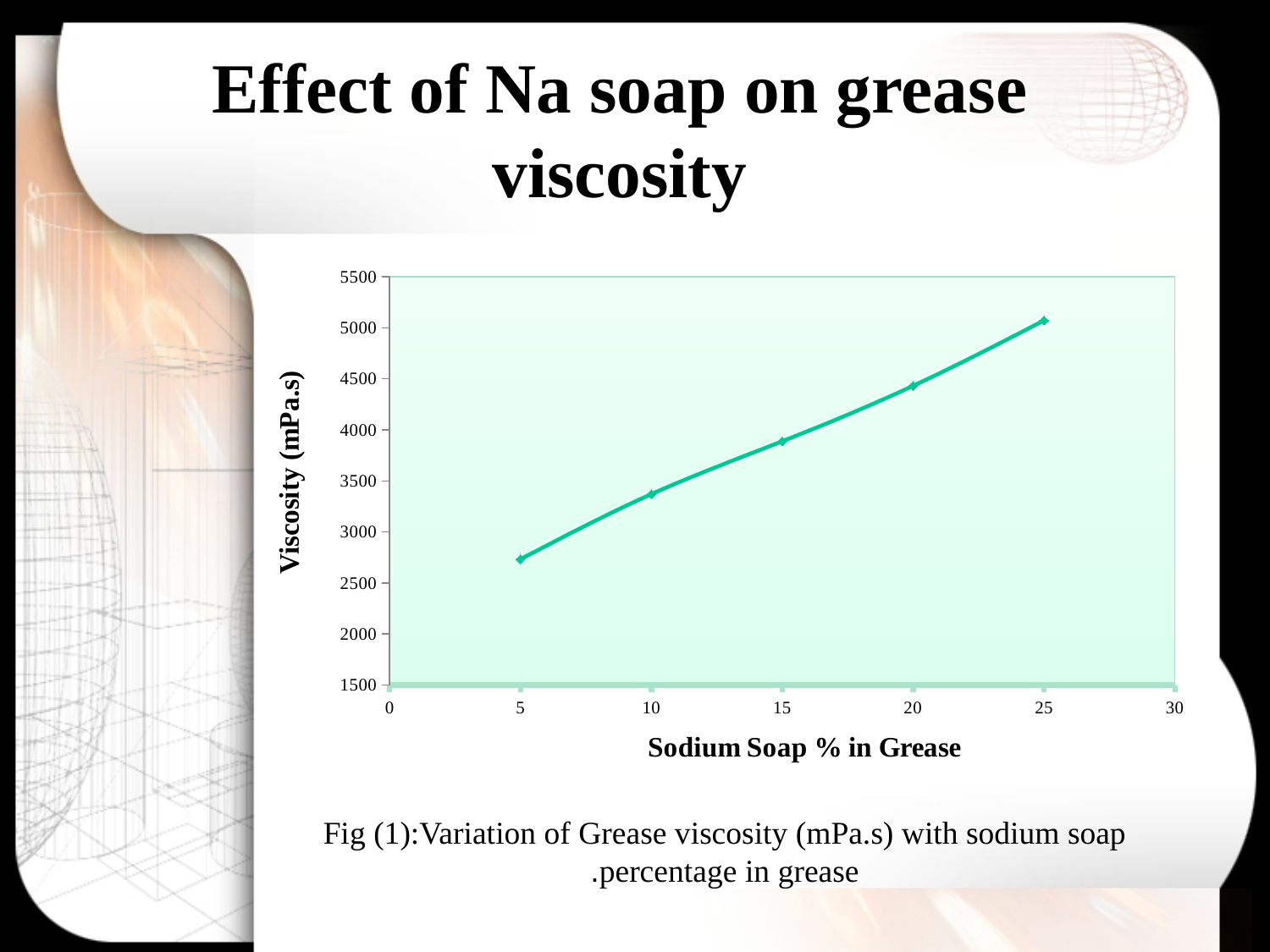
What is the label of the y axis? Viscosity (mPa.s) Is the viscosity at 10% sodium soap greater or less than 3000? greater Is the viscosity at 5% sodium soap greater or less than 3000? less Is the viscosity at 25% sodium soap greater or less than 4500? greater Which has the higher viscosity: 10% sodium soap or 20% sodium soap? 20% sodium soap At which sodium soap percentage is the viscosity lowest? 5 At which sodium soap percentage is the viscosity highest? 25 How many data points are plotted on the line? 5 What kind of chart is shown on the slide? line chart Does viscosity rise or fall as the sodium soap percentage increases? rise